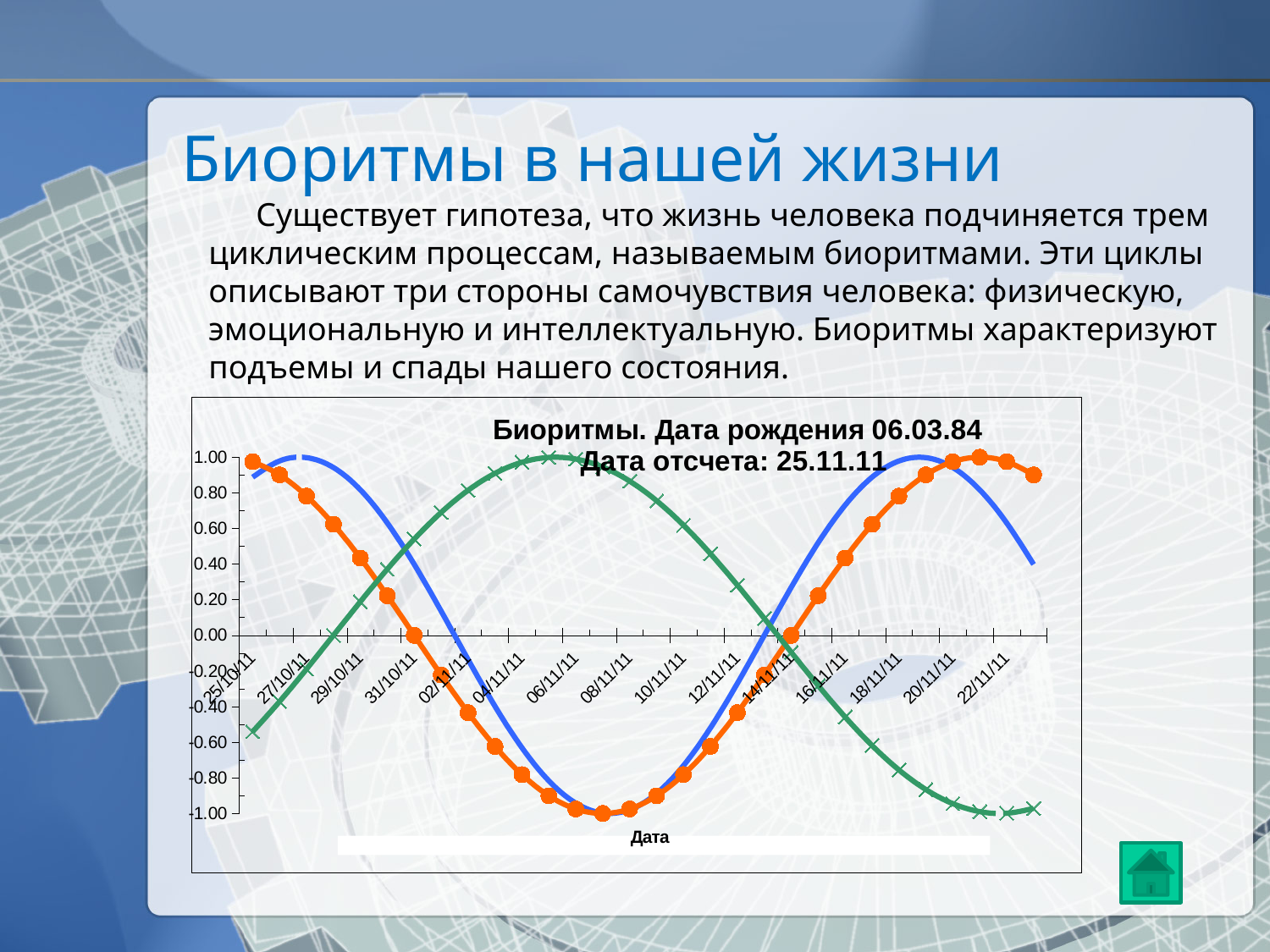
What is the title of the chart? Биоритмы. Дата рождения 06.03.84 Дата отсчета: 25.11.11 How many lines (series) are plotted on the chart? 3 Is the value of the orange line with circle markers at 06/11/11 greater or less than -0.80? less Is the value of the orange line with circle markers at 25/10/11 greater or less than 0.80? greater How many date labels are shown along the x axis? 15 Is the value of the green line with x markers at 06/11/11 greater or less than 0.80? greater Does the orange line with circle markers rise or fall from 25/10/11 to 06/11/11? fall Does the green line with x markers rise or fall from 25/10/11 to 06/11/11? rise At 06/11/11, which line has the higher value: the green line with x markers or the orange line with circle markers? the green line with x markers What is the label of the x axis of the chart? Дата What kind of chart is shown on the slide? line chart